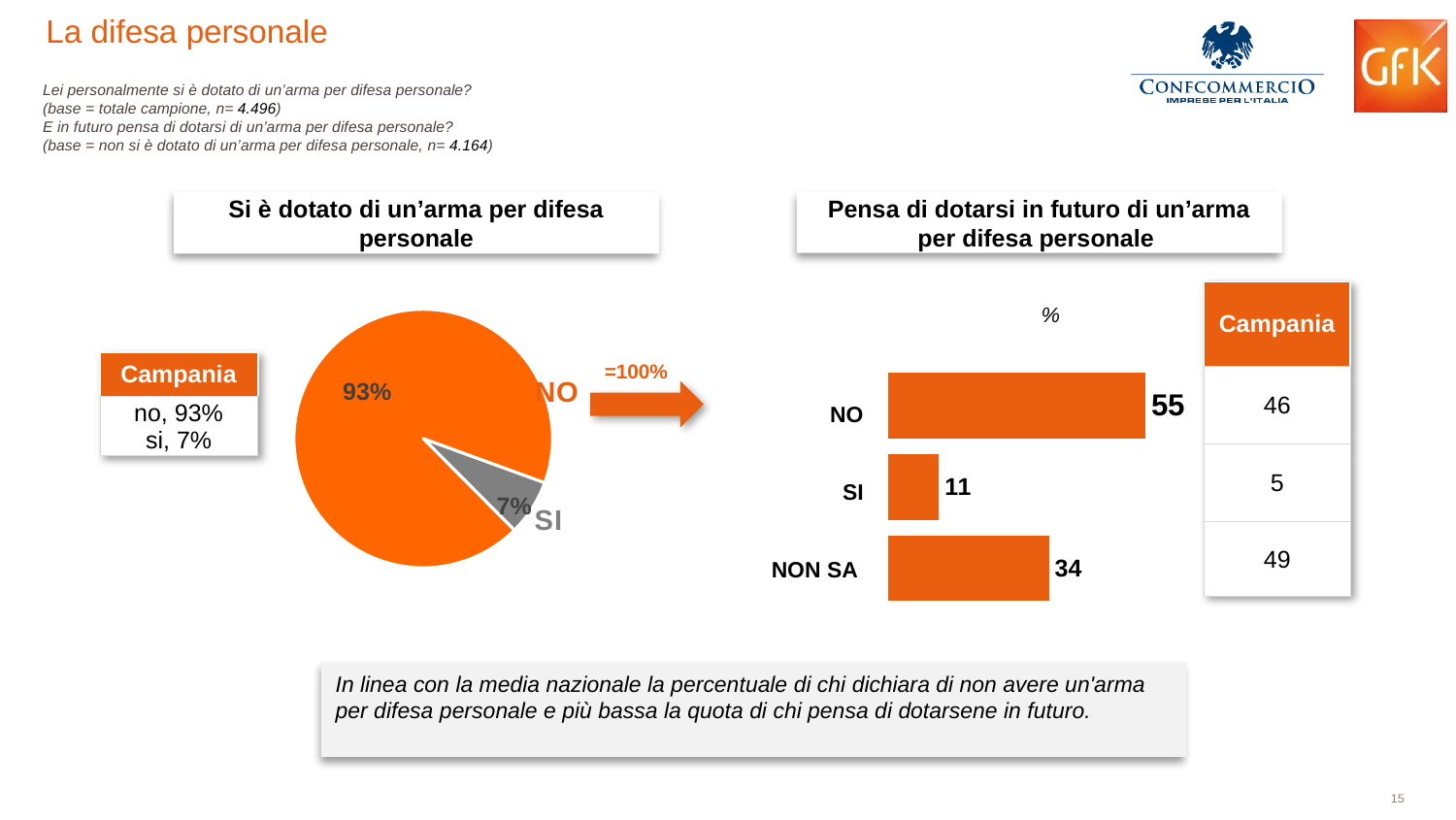
What kind of chart is the one titled 'Pensa di dotarsi in futuro di un'arma per difesa personale'? Bar chart In the bar chart 'Pensa di dotarsi in futuro di un'arma per difesa personale', what is the value for NON SA? 34 In the pie chart 'Si è dotato di un'arma per difesa personale', which slice is larger, NO or SI? NO In the pie chart 'Si è dotato di un'arma per difesa personale', what share is labelled NO? 93% In the pie chart 'Si è dotato di un'arma per difesa personale', what is the difference between the NO and SI shares? 86% What kind of chart is the one titled 'Si è dotato di un'arma per difesa personale'? Pie chart In the pie chart 'Si è dotato di un'arma per difesa personale', how many slices are there? 2 In the pie chart 'Si è dotato di un'arma per difesa personale', what share is labelled SI? 7% In the bar chart 'Pensa di dotarsi in futuro di un'arma per difesa personale', what is the difference between NO and NON SA? 21 In the bar chart 'Pensa di dotarsi in futuro di un'arma per difesa personale', which category has the lowest value? SI In the bar chart 'Pensa di dotarsi in futuro di un'arma per difesa personale', what is the value for NO? 55 In the bar chart 'Pensa di dotarsi in futuro di un'arma per difesa personale', which category has the highest value? NO